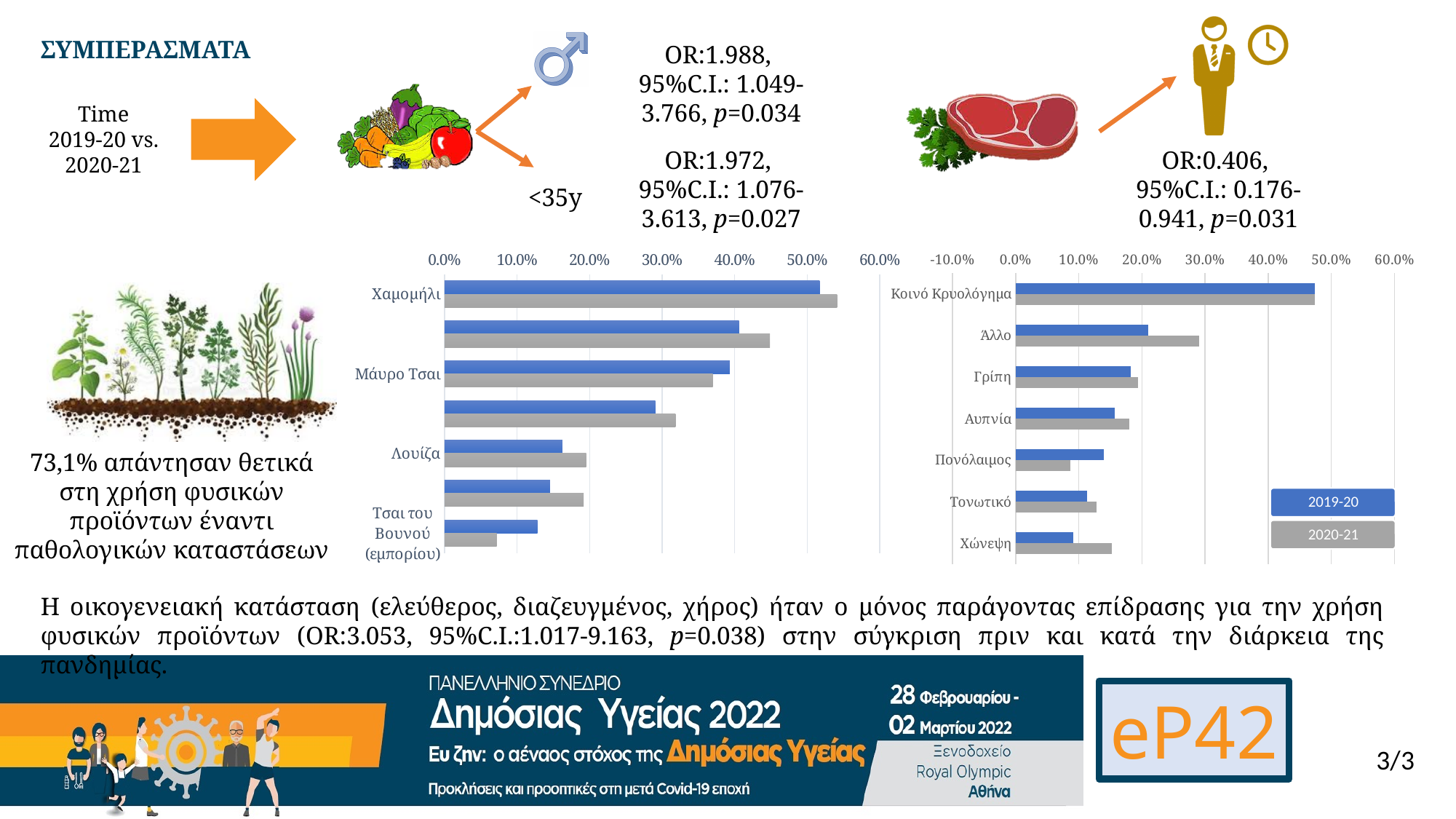
In the right chart, is the 2020-21 value for Άλλο greater or less than 20.0%? greater In the right chart, which category has the lowest value for 2020-21? Πονόλαιμος In the left chart, for Τσαι του Βουνού (εμπορίου), which series has the larger value, 2019-20 or 2020-21? 2019-20 How many series does the legend list for the charts? 2 In the left chart, which category has the highest value for 2019-20? Χαμομήλι What colour represents the 2020-21 series in the charts? grey What kind of chart is the left chart (the one starting with Χαμομήλι)? bar chart In the left chart, is the 2019-20 value for Λουίζα greater or less than 20.0%? less In the right chart, is the 2019-20 value for Κοινό Κρυολόγημα greater or less than 40.0%? greater In the right chart, for Χώνεψη, which series has the larger value, 2019-20 or 2020-21? 2020-21 In the right chart (the one starting with Κοινό Κρυολόγημα), how many categories are plotted? 7 In the right chart, which category has the highest value for 2019-20? Κοινό Κρυολόγημα